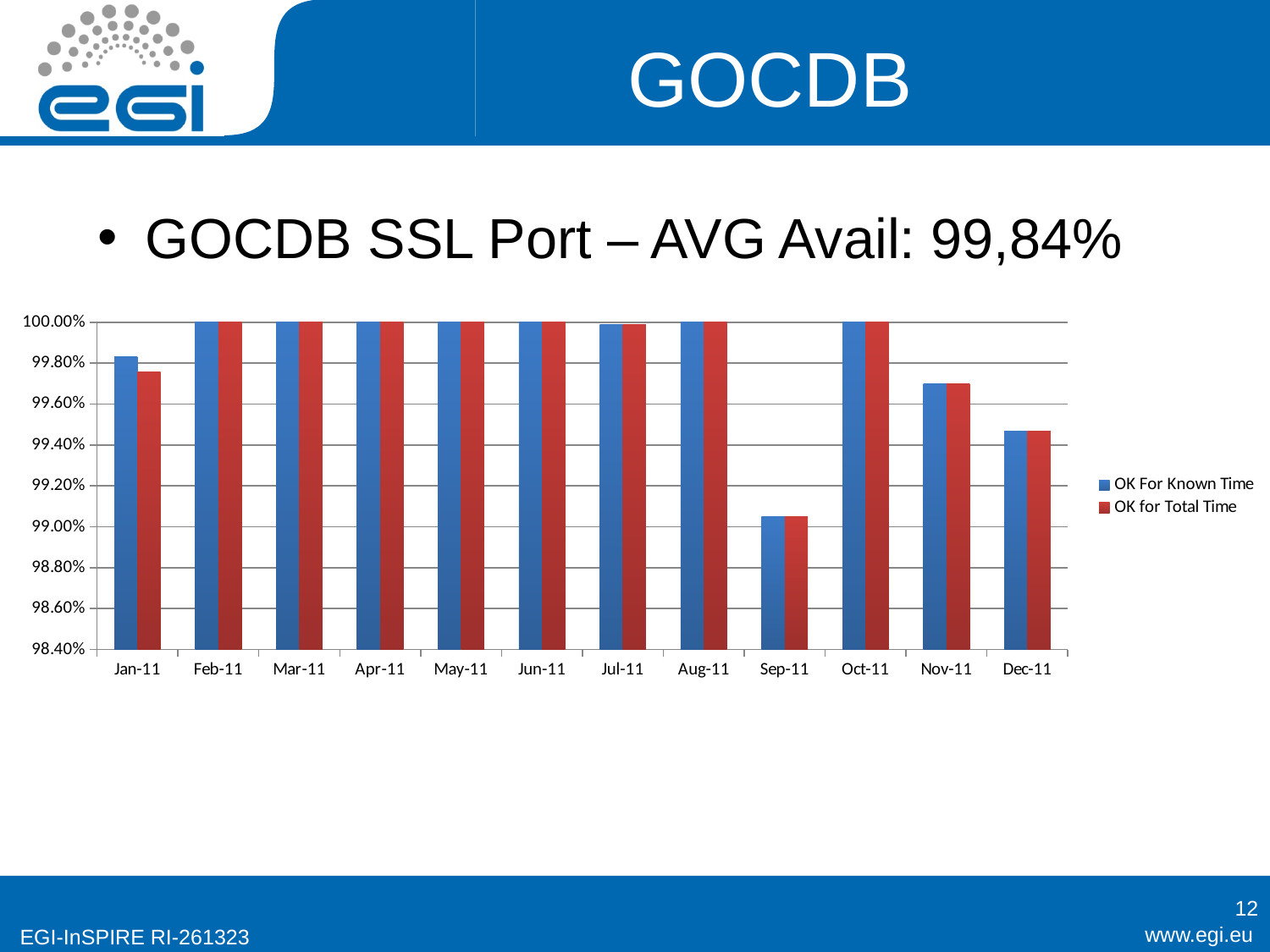
What kind of chart is shown on the slide? bar chart Is the OK For Known Time value for Sep-11 greater or less than 99.20%? less How many series does the chart's legend list? 2 Is the OK for Total Time value for Dec-11 greater or less than 99.60%? less Do the OK For Known Time values rise or fall from Oct-11 to Dec-11? fall What is the OK for Total Time value for Feb-11? 100.00% Which month has the lowest OK For Known Time value? Sep-11 How many months are shown on the x axis of the chart? 12 Which month has the larger OK for Total Time value, Nov-11 or Dec-11? Nov-11 For Jan-11, which is larger: OK For Known Time or OK for Total Time? OK For Known Time Is the OK For Known Time value for Nov-11 greater or less than 99.60%? greater